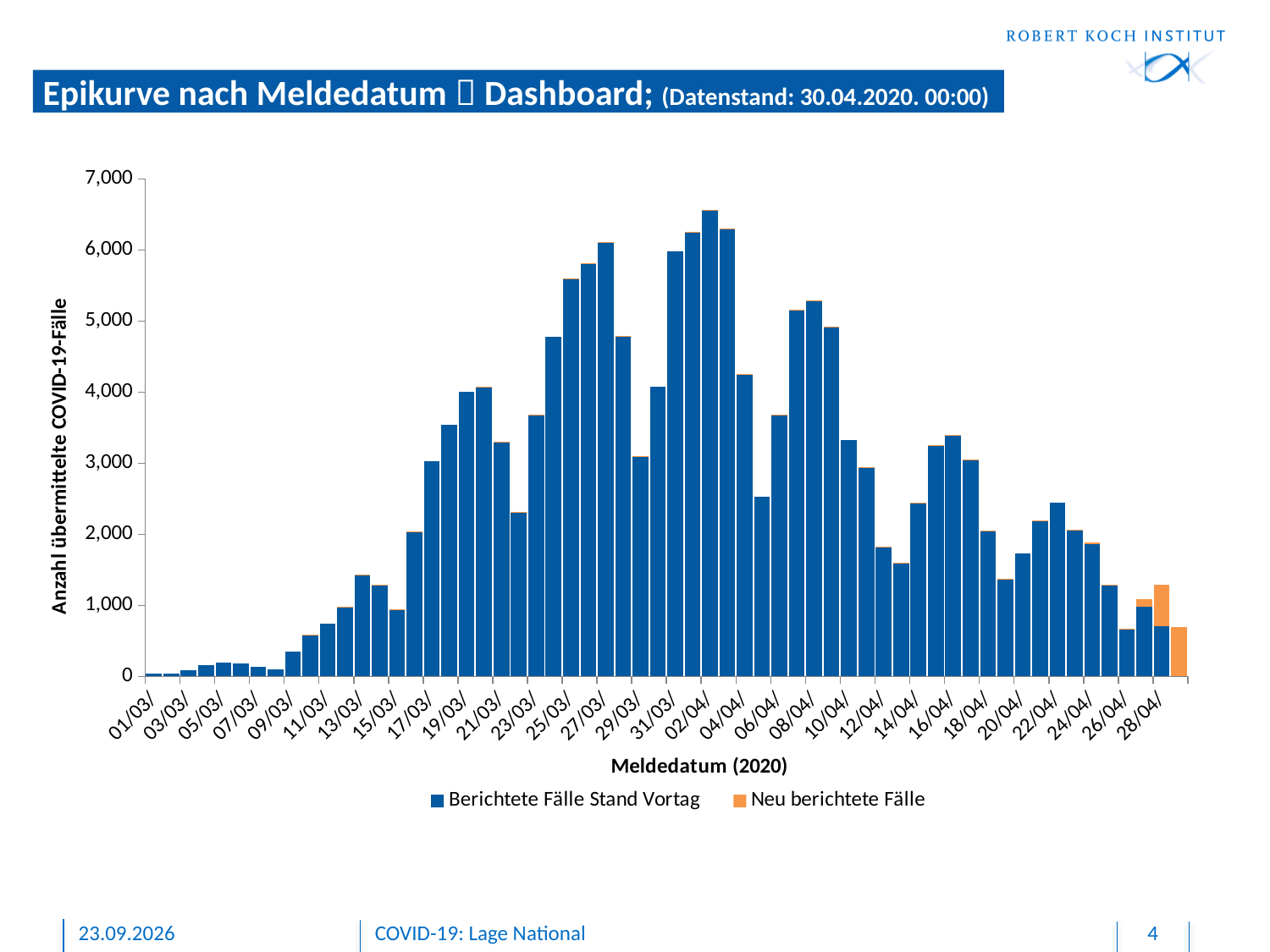
What kind of chart is shown on the slide? bar chart Is the value for 29/03/ greater or less than 4,000? less Is the value for 01/03/ greater or less than 1,000? less Do the bars generally rise or fall from 01/03/ to 02/04/? rise How many series does the legend list? 2 Which is larger, the value for 25/03/ or the value for 12/04/? 25/03/ Is the value for 06/04/ greater or less than 3,000? greater What are the two series named in the legend? Berichtete Fälle Stand Vortag; Neu berichtete Fälle What is the title of the y axis? Anzahl übermittelte COVID-19-Fälle Which date has the highest bar? 02/04/